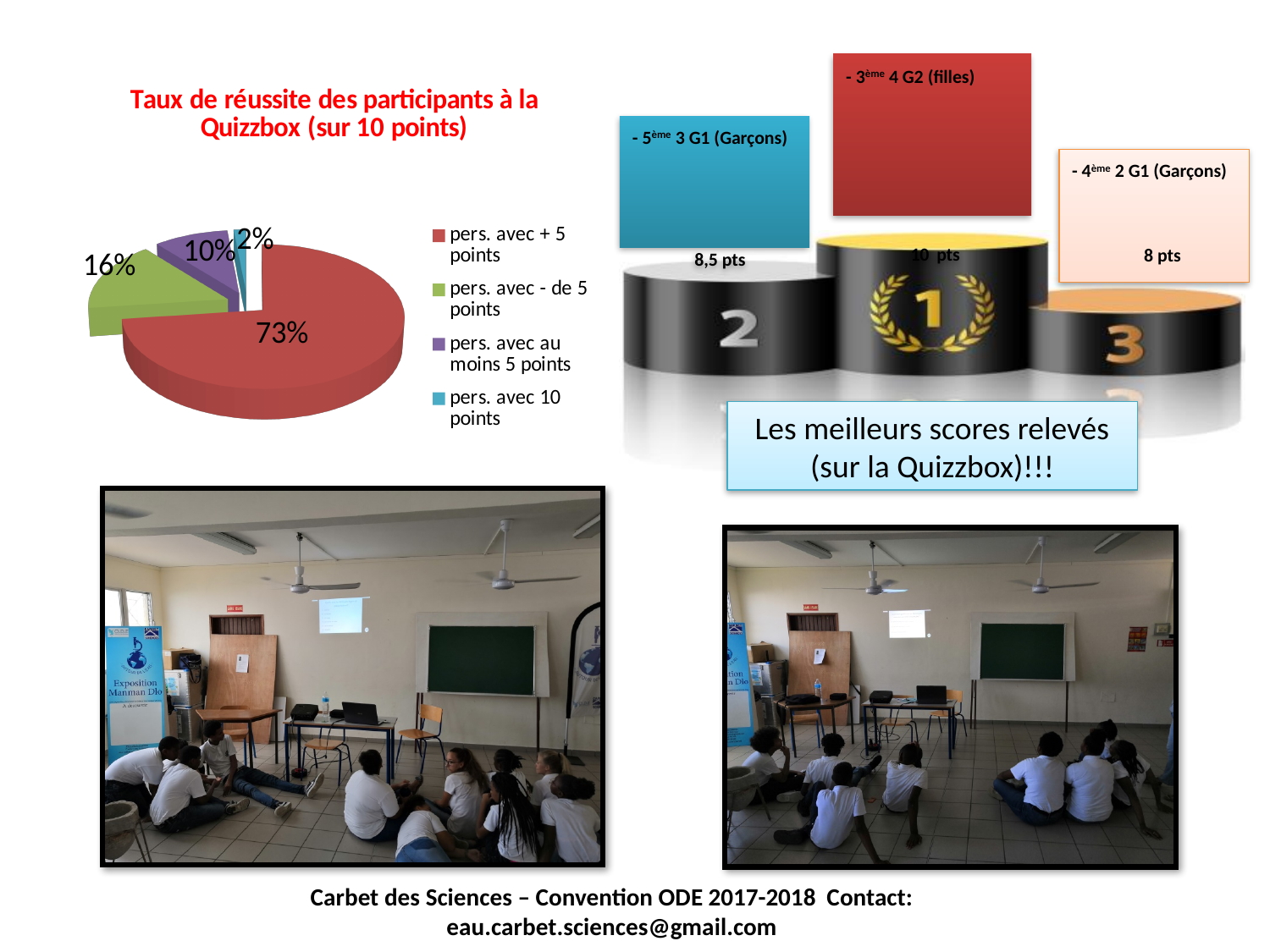
What percentage of the pie chart is for "pers. avec 10 points"? 2% How many entries does the pie chart's legend list? 4 Which is larger: the slice for "pers. avec - de 5 points" or the slice for "pers. avec au moins 5 points"? pers. avec - de 5 points How many slices does the pie chart have? 4 What percentage of the pie chart is for "pers. avec au moins 5 points"? 10% What is the difference in percentage points between "pers. avec + 5 points" and "pers. avec - de 5 points"? 57 What percentage of the pie chart is for "pers. avec + 5 points"? 73% Which category has the largest slice of the pie chart? pers. avec + 5 points What type of chart is shown on the slide? pie chart Which category has the smallest slice of the pie chart? pers. avec 10 points What percentage of the pie chart is for "pers. avec - de 5 points"? 16% What is the title of the pie chart? Taux de réussite des participants à la Quizzbox (sur 10 points)